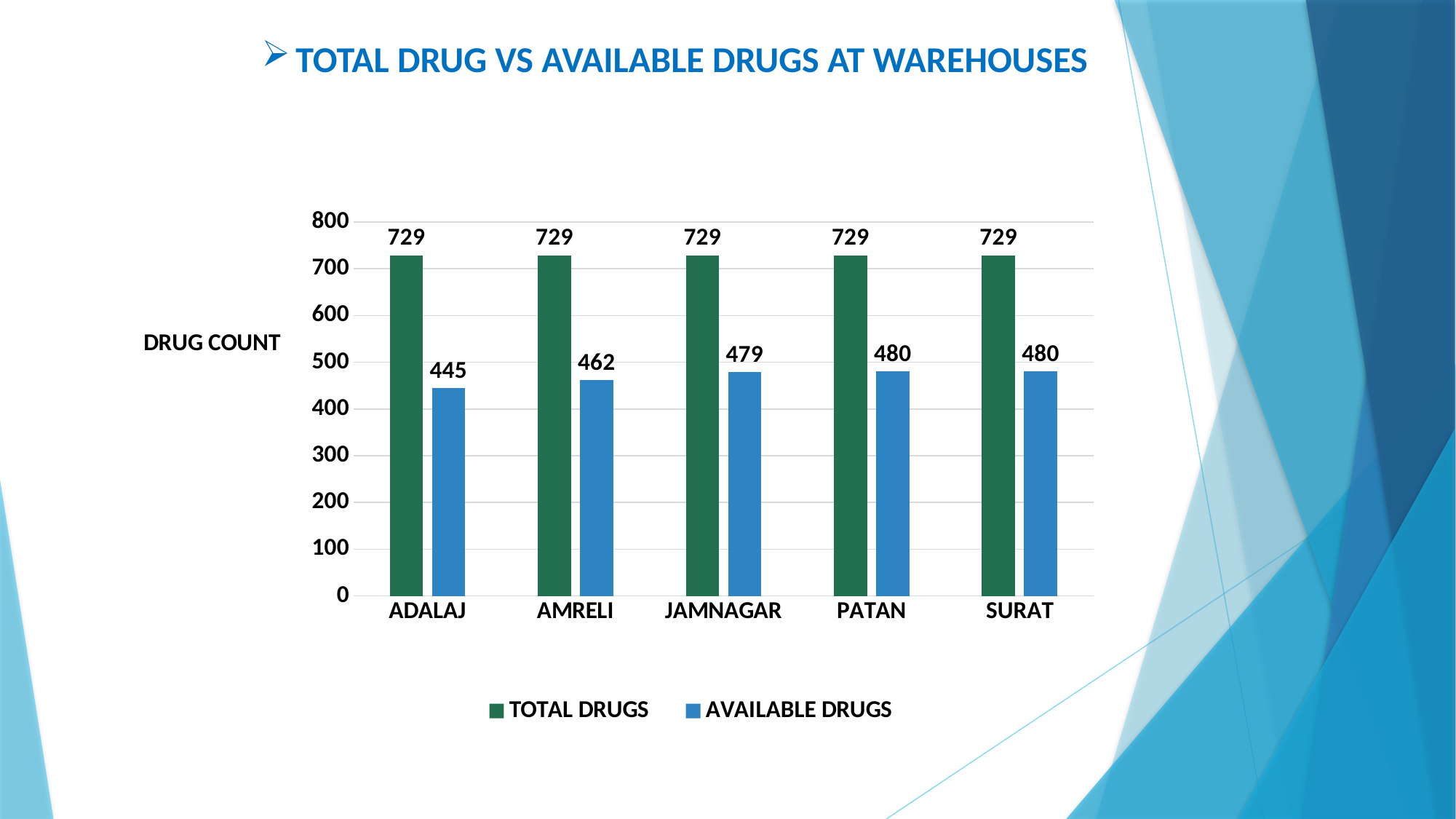
How many warehouses are shown on the x axis? 5 How many series does the legend list? 2 What is the difference in AVAILABLE DRUGS between SURAT and ADALAJ? 35 What kind of chart is shown on the slide? bar chart What is the value of AVAILABLE DRUGS for ADALAJ? 445 What is the label of the vertical axis? DRUG COUNT What is the value of AVAILABLE DRUGS for JAMNAGAR? 479 Is the AVAILABLE DRUGS value for ADALAJ greater or less than 500? less What is the difference between TOTAL DRUGS and AVAILABLE DRUGS for AMRELI? 267 What is the value of TOTAL DRUGS for PATAN? 729 Which is larger, AVAILABLE DRUGS for AMRELI or AVAILABLE DRUGS for JAMNAGAR? JAMNAGAR Which warehouse has the lowest AVAILABLE DRUGS value? ADALAJ